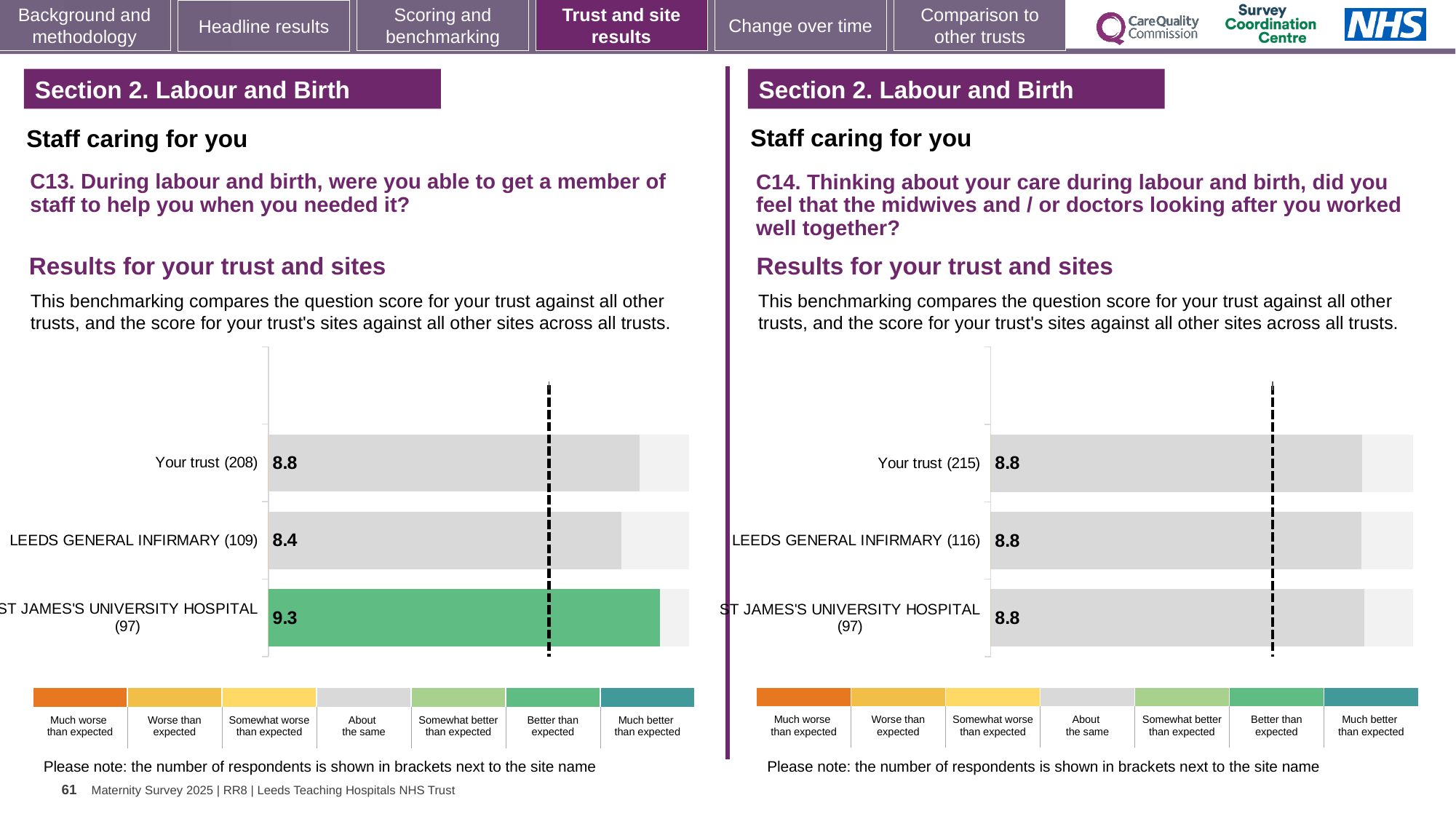
In the C13 chart on the left, how many respondents are shown in brackets for Your trust? 208 How many bars are shown in the C14 chart on the right? 3 In the C13 chart on the left, which has the larger score, Your trust or LEEDS GENERAL INFIRMARY? Your trust In the C13 chart on the left, what is the score for ST JAMES'S UNIVERSITY HOSPITAL? 9.3 What type of chart is used for the C13 results on the left? Bar chart In the C14 chart on the right, what is the score for ST JAMES'S UNIVERSITY HOSPITAL? 8.8 In the C13 chart on the left, which site or trust has the lowest score? LEEDS GENERAL INFIRMARY In the C13 chart on the left, what is the score for Your trust? 8.8 In the C13 chart on the left, what is the difference between the scores for ST JAMES'S UNIVERSITY HOSPITAL and LEEDS GENERAL INFIRMARY? 0.9 In the C14 chart on the right, what is the score for LEEDS GENERAL INFIRMARY? 8.8 In the C13 chart on the left, which site or trust has the highest score? ST JAMES'S UNIVERSITY HOSPITAL In the C13 chart on the left, what is the score for LEEDS GENERAL INFIRMARY? 8.4